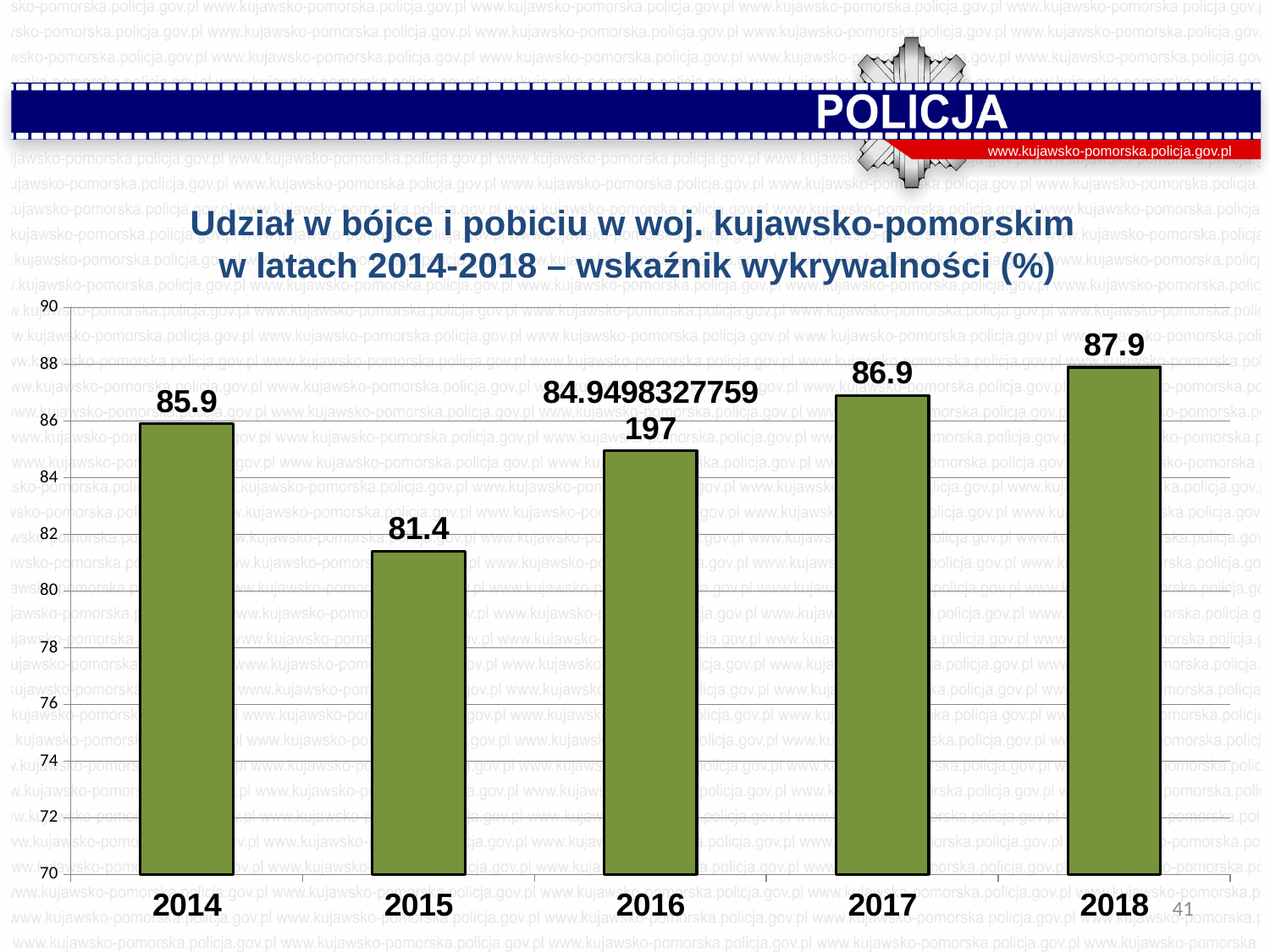
What is the difference between the values for 2017 and 2015? 5.5 What is the value for 2017? 86.9 What is the value for 2015? 81.4 What is the difference between the values for 2018 and 2014? 2.0 What kind of chart is shown on the slide? bar chart What is the value for 2014? 85.9 Which is larger, the value for 2014 or the value for 2016? 2014 Which year has the highest value? 2018 Is the value for 2015 greater or less than 80? greater How many years are shown on the x axis? 5 What is the value for 2018? 87.9 Which year has the lowest value? 2015